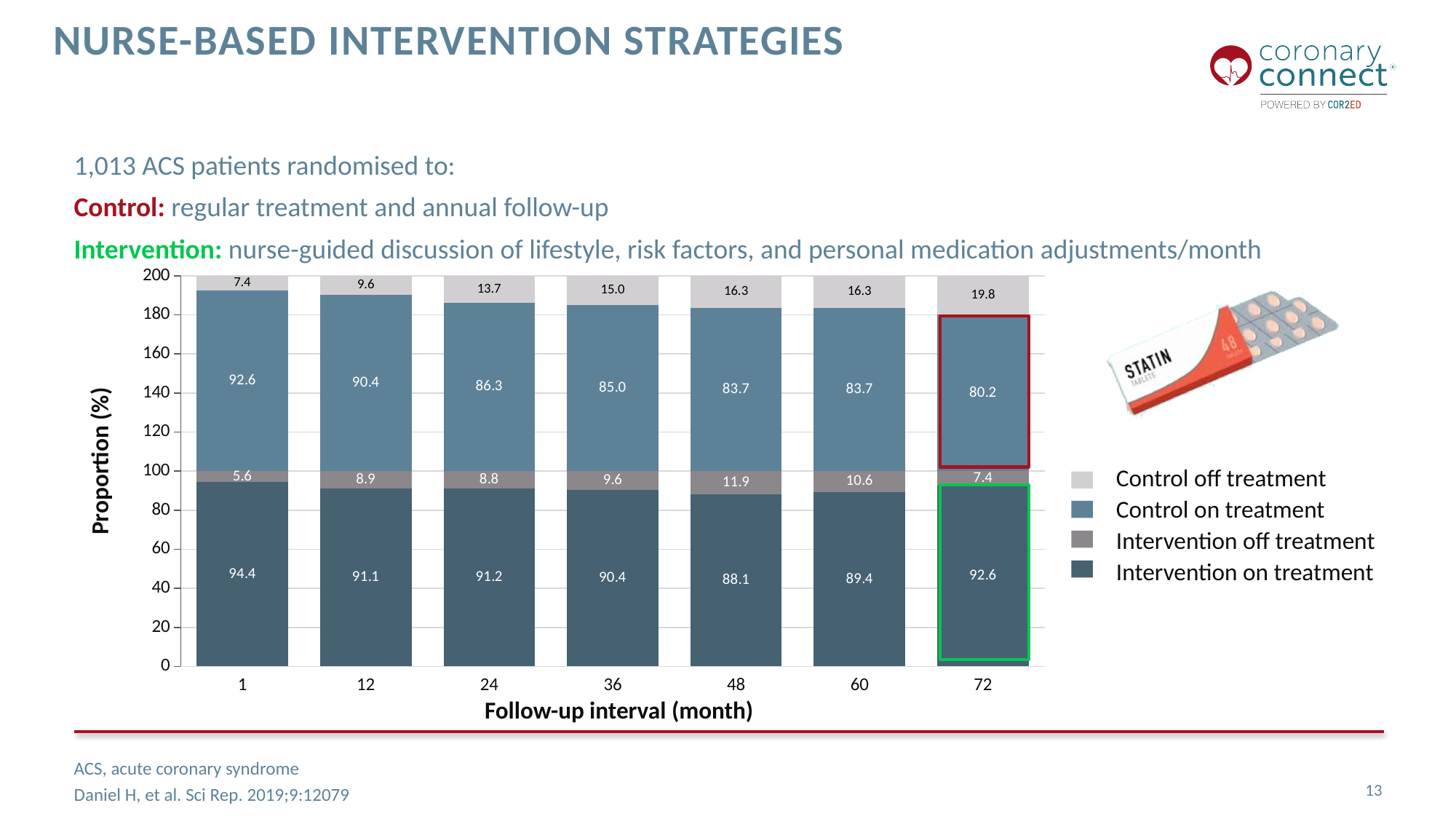
What is the value for Control on treatment at the 1-month follow-up? 92.6 Does the Control off treatment value rise or fall as the follow-up interval increases? Rise At the 60-month follow-up, which is larger: Intervention on treatment or Control on treatment? Intervention on treatment What kind of chart is shown on the slide? Stacked bar chart How many series does the legend list? 4 At which follow-up interval is the Control off treatment value highest? 72 What is the value for Intervention off treatment at the 48-month follow-up? 11.9 What is the value for Intervention on treatment at the 72-month follow-up? 92.6 What is the value for Control off treatment at the 72-month follow-up? 19.8 What is the difference between the Control on treatment value at 1 month and at 72 months? 12.4 At which follow-up interval is the Control on treatment value lowest? 72 How many follow-up intervals are shown on the x axis? 7